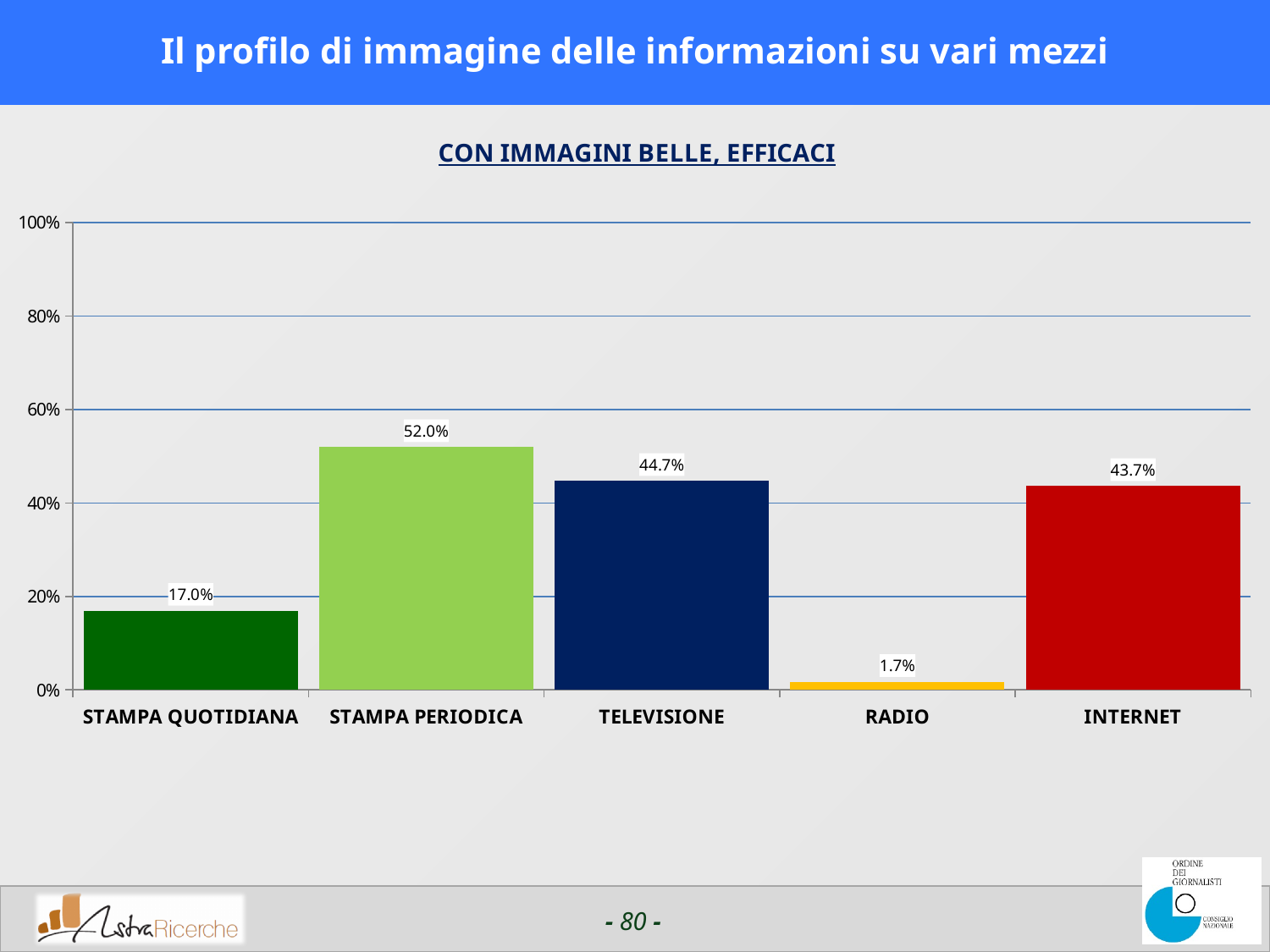
What is the value for RADIO? 1.7% Which category has the highest value? STAMPA PERIODICA What is the value for INTERNET? 43.7% Which is larger, the value for TELEVISIONE or the value for STAMPA QUOTIDIANA? TELEVISIONE Which category has the lowest value? RADIO How many categories are shown on the x axis? 5 Is the value for STAMPA QUOTIDIANA greater or less than 20%? less What is the value for STAMPA QUOTIDIANA? 17.0% What is the value for STAMPA PERIODICA? 52.0% What is the difference between the values for STAMPA PERIODICA and TELEVISIONE? 7.3% What kind of chart is shown on the slide? bar chart What is the subtitle shown above the chart? CON IMMAGINI BELLE, EFFICACI